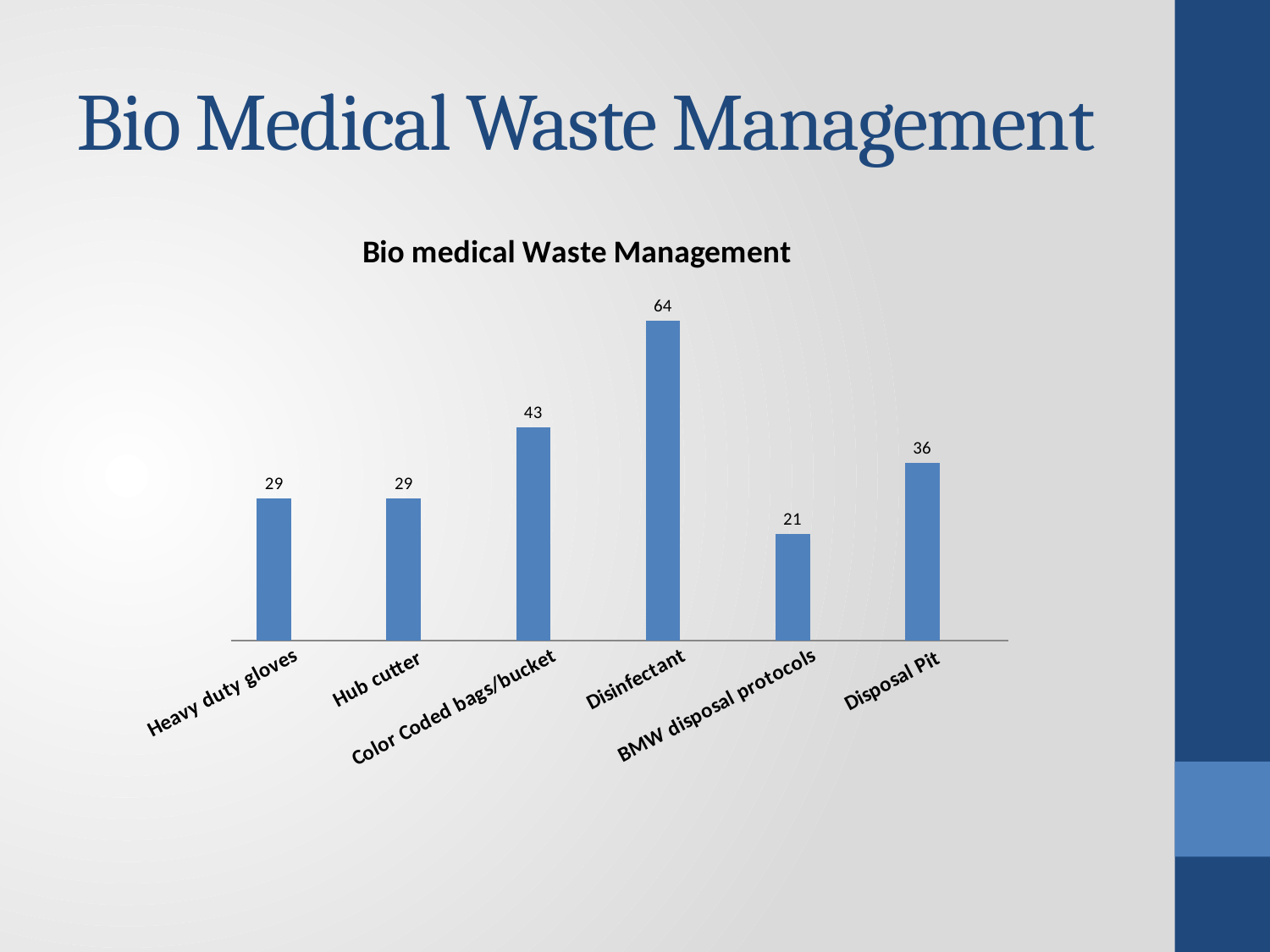
What kind of chart is shown on the slide? Bar chart What is the title of the chart? Bio medical Waste Management What is the value for Disinfectant? 64 What is the value for Disposal Pit? 36 What is the difference between the values for Disposal Pit and BMW disposal protocols? 15 What is the value for Color Coded bags/bucket? 43 How many categories are shown on the chart? 6 Which is larger, the value for Hub cutter or the value for Disposal Pit? Disposal Pit What is the difference between the values for Disinfectant and Color Coded bags/bucket? 21 Which category has the highest value? Disinfectant What is the value for BMW disposal protocols? 21 Which category has the lowest value? BMW disposal protocols